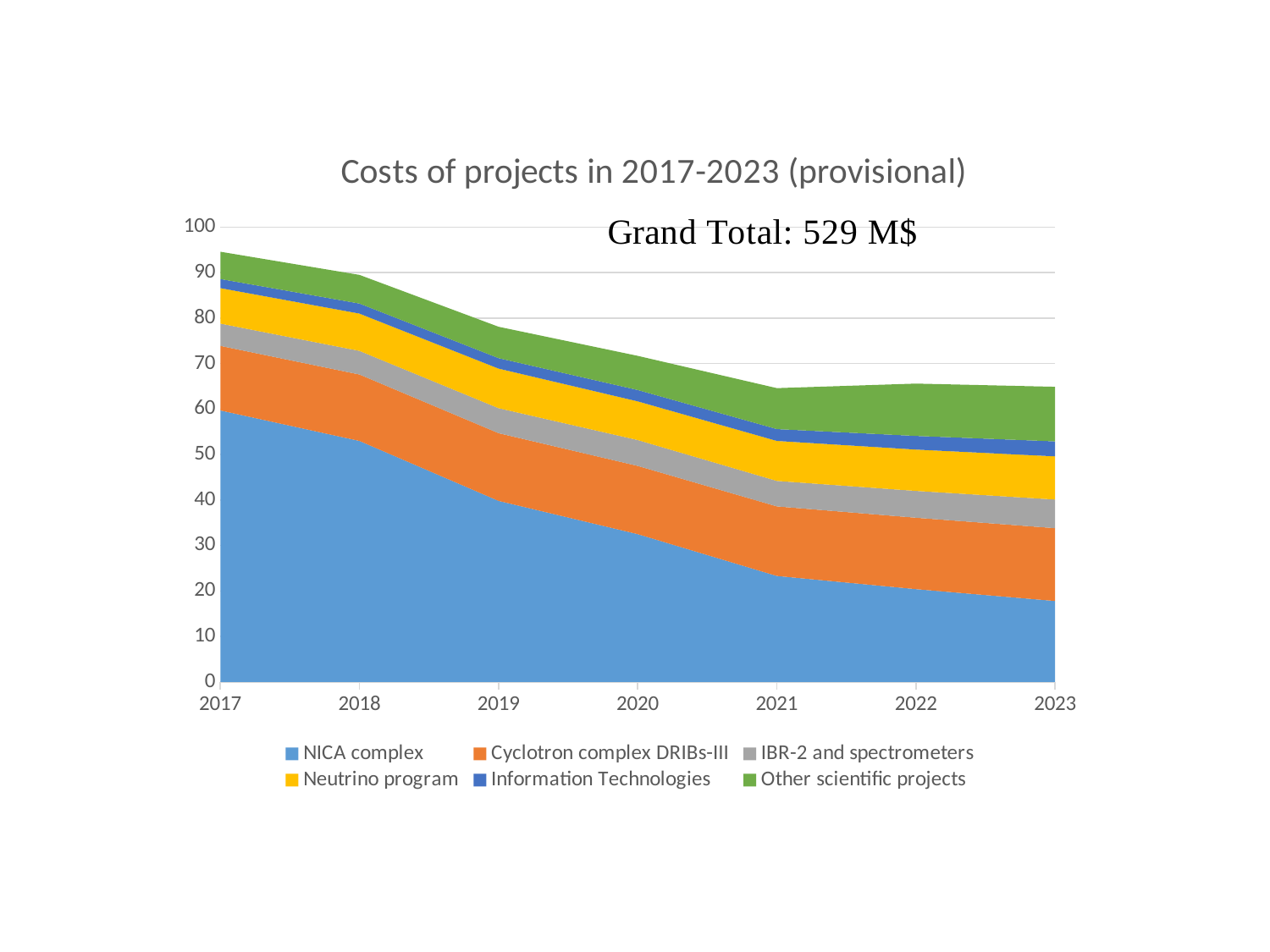
What grand total is stated on the chart? 529 M$ How many series does the legend list? 6 Is the total stacked value for 2017 greater or less than 90? greater Is the total stacked value for 2023 greater or less than 60? greater Is the value for NICA complex in 2023 greater or less than 20? less Which year has the highest total stacked cost? 2017 What is the title of the chart? Costs of projects in 2017-2023 (provisional) Does the total stacked cost of all projects rise or fall from 2017 to 2021? Fall Does the NICA complex cost rise or fall from 2017 to 2023? Fall How many years are shown along the x axis? 7 What kind of chart is shown on the slide? Stacked area chart